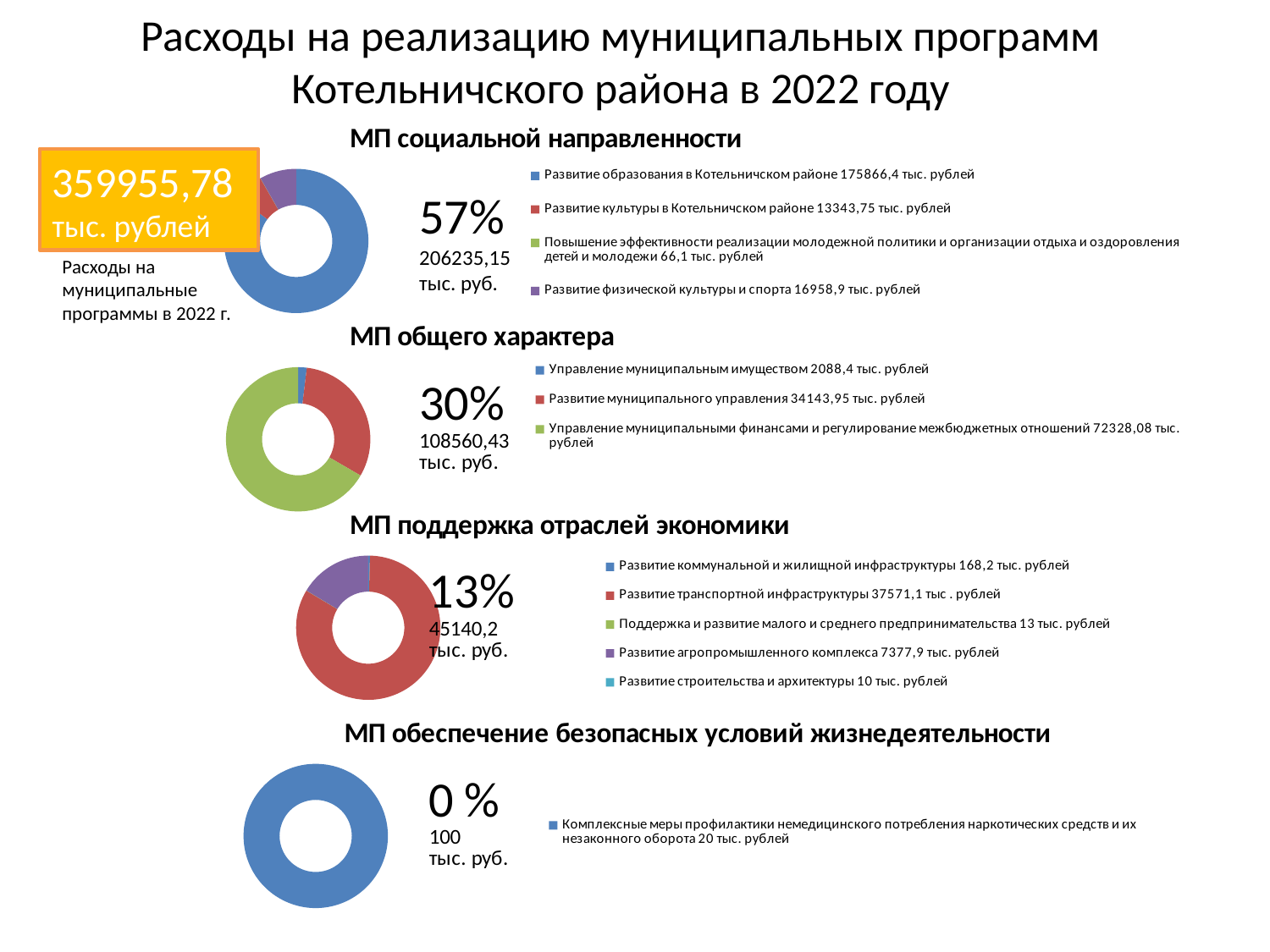
In the "МП поддержка отраслей экономики" chart, how many entries does the legend list? 5 In the "МП социальной направленности" chart, which program has the smallest value? Повышение эффективности реализации молодежной политики и организации отдыха и оздоровления детей и молодежи In the "МП общего характера" chart, which program has the largest value? Управление муниципальными финансами и регулирование межбюджетных отношений In the "МП социальной направленности" chart, how many entries does the legend list? 4 In the "МП социальной направленности" chart, what share of total expenditure does this group represent, as printed next to the chart? 57% In the "МП поддержка отраслей экономики" chart, what is the difference between "Развитие коммунальной и жилищной инфраструктуры" (168,2) and "Развитие строительства и архитектуры" (10)? 158,2 тыс. рублей In the "МП общего характера" chart, what is the value for "Развитие муниципального управления"? 34143,95 тыс. рублей In the "МП поддержка отраслей экономики" chart, which is larger: "Развитие транспортной инфраструктуры" or "Развитие агропромышленного комплекса"? Развитие транспортной инфраструктуры In the "МП социальной направленности" chart, what is the value for "Развитие образования в Котельничском районе"? 175866,4 тыс. рублей In the "МП общего характера" chart, how many programs are listed in the legend? 3 What kind of chart is used for "МП социальной направленности"? doughnut chart In the "МП обеспечение безопасных условий жизнедеятельности" chart, what is the value for "Комплексные меры профилактики немедицинского потребления наркотических средств и их незаконного оборота"? 20 тыс. рублей